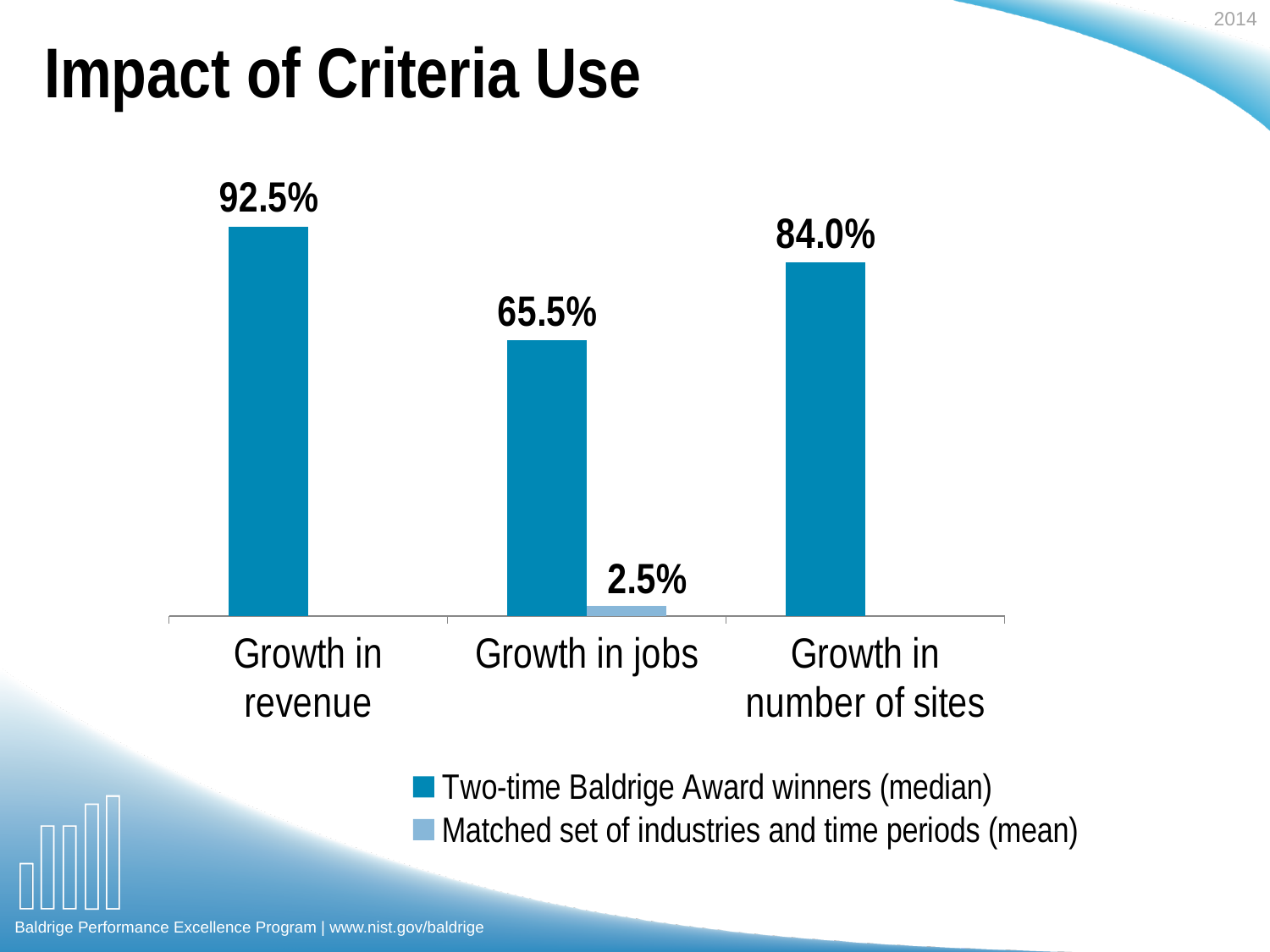
How many series does the legend list? 2 What kind of chart is shown on the slide? Bar chart What is the value for Two-time Baldrige Award winners (median) for Growth in revenue? 92.5% Which is larger for Two-time Baldrige Award winners (median): Growth in jobs or Growth in number of sites? Growth in number of sites How many categories are shown on the x axis? 3 For Growth in jobs, what is the difference between the Two-time Baldrige Award winners (median) value and the Matched set of industries and time periods (mean) value? 63.0% Which category has the lowest value for Two-time Baldrige Award winners (median)? Growth in jobs What is the value for Matched set of industries and time periods (mean) for Growth in jobs? 2.5% What is the difference between the Two-time Baldrige Award winners (median) values for Growth in revenue and Growth in number of sites? 8.5% Which category has the highest value for Two-time Baldrige Award winners (median)? Growth in revenue What is the value for Two-time Baldrige Award winners (median) for Growth in jobs? 65.5% What is the value for Two-time Baldrige Award winners (median) for Growth in number of sites? 84.0%